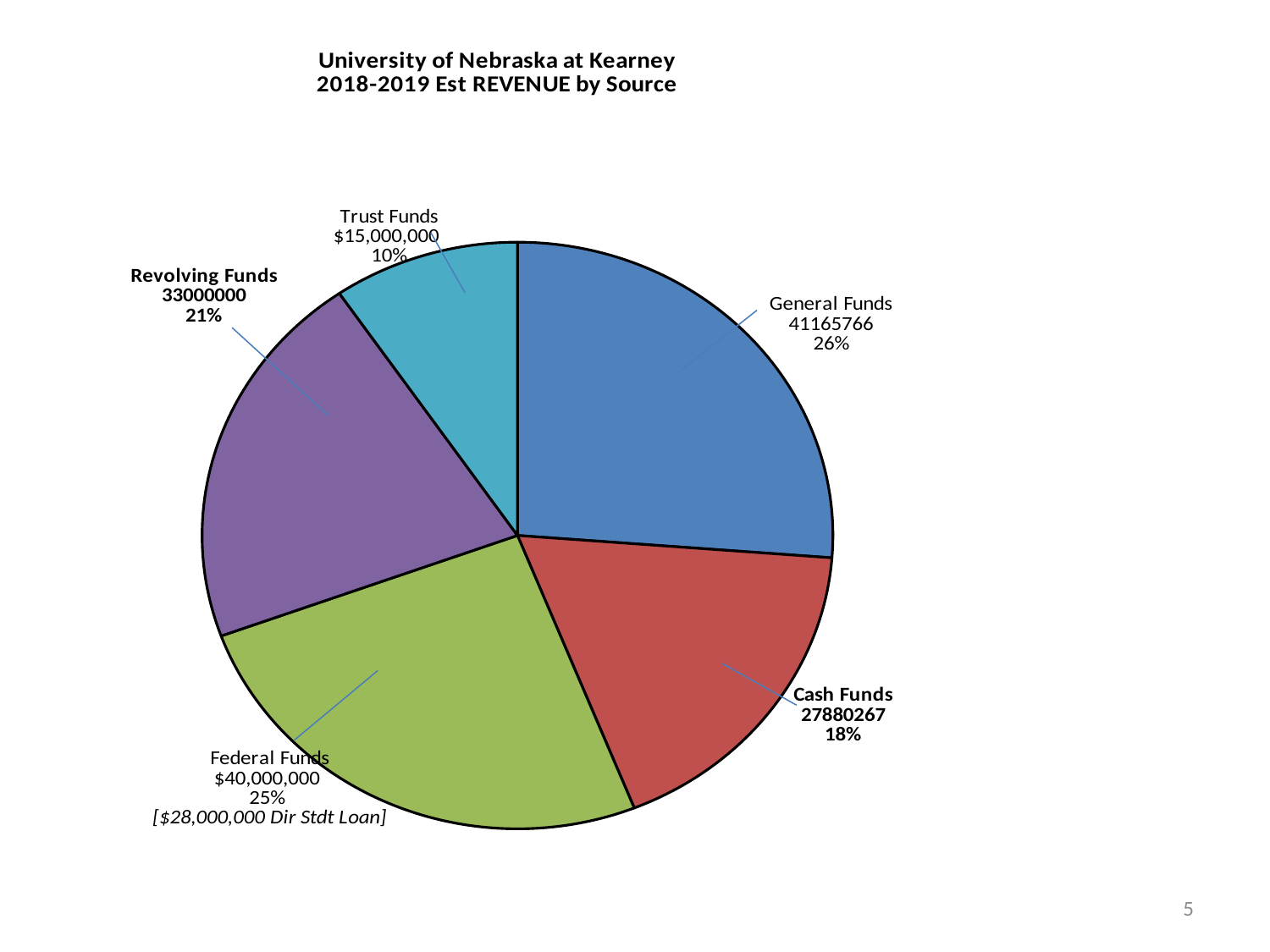
What is the value shown for Trust Funds? $15,000,000 What share of the pie does General Funds represent? 26% Which revenue source has the largest share of the pie? General Funds Which is larger, the share for Cash Funds or the share for Revolving Funds? Revolving Funds Which revenue source has the smallest share of the pie? Trust Funds What is the value shown for Federal Funds? $40,000,000 What share of the pie does Revolving Funds represent? 21% How many revenue sources (slices) does the pie chart show? 5 What is the value shown for Cash Funds? 27880267 What kind of chart is shown on the slide? Pie chart What is the value shown for General Funds? 41165766 What is the title of the chart? University of Nebraska at Kearney 2018-2019 Est REVENUE by Source